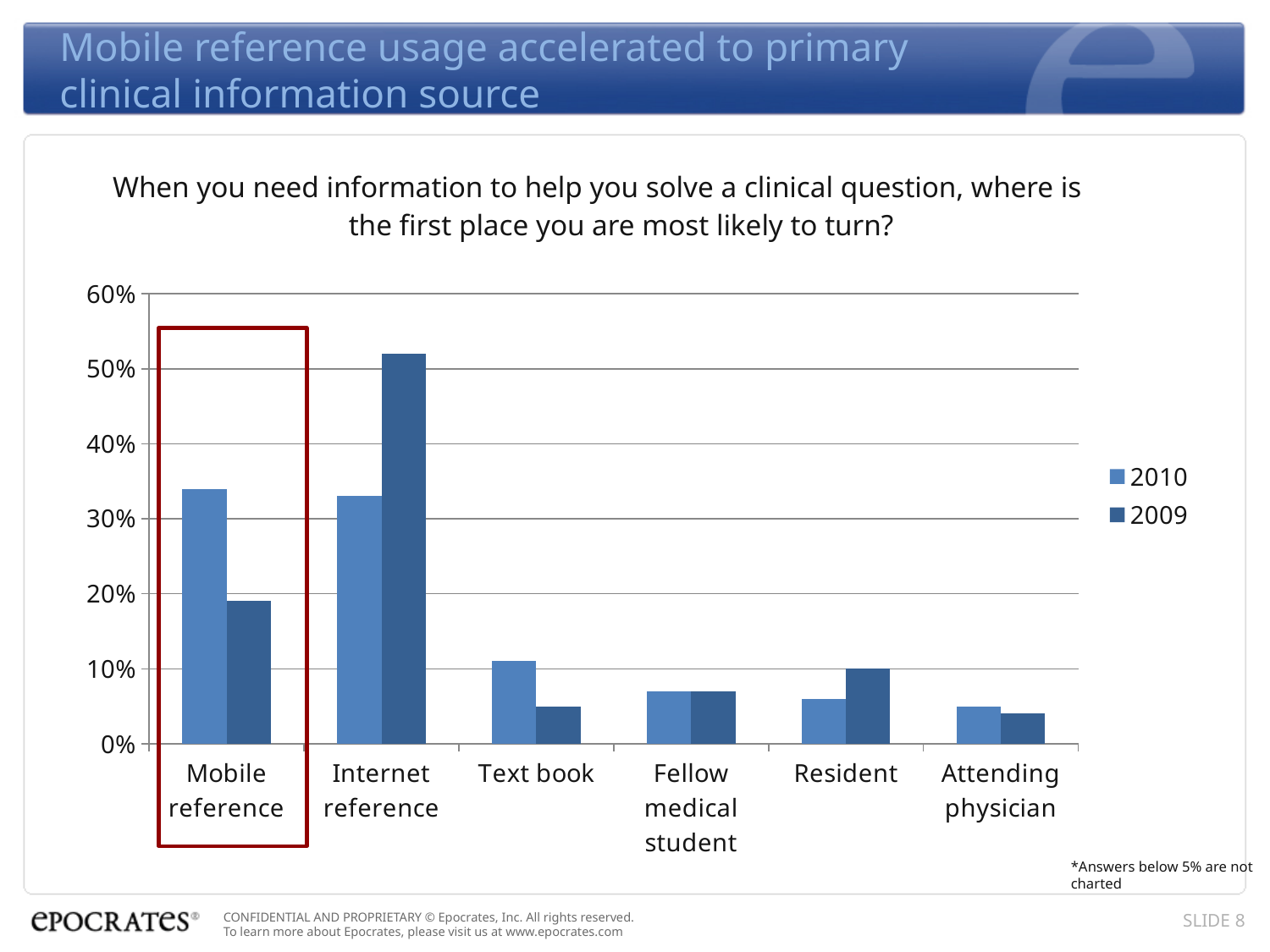
How many categories are shown on the x axis of the chart? 6 How many series does the chart's legend list? 2 Is the 2010 value for Mobile reference greater or less than 30%? greater Which category has the highest value for the 2009 series? Internet reference For Internet reference, which series has the larger value, 2010 or 2009? 2009 For Mobile reference, which series has the larger value, 2010 or 2009? 2010 Is the 2009 value for Internet reference greater or less than 40%? greater For Resident, which series has the larger value, 2010 or 2009? 2009 Which category on the chart is highlighted with a red box? Mobile reference What kind of chart is shown on the slide? bar chart Is the 2009 value for Text book greater or less than 10%? less